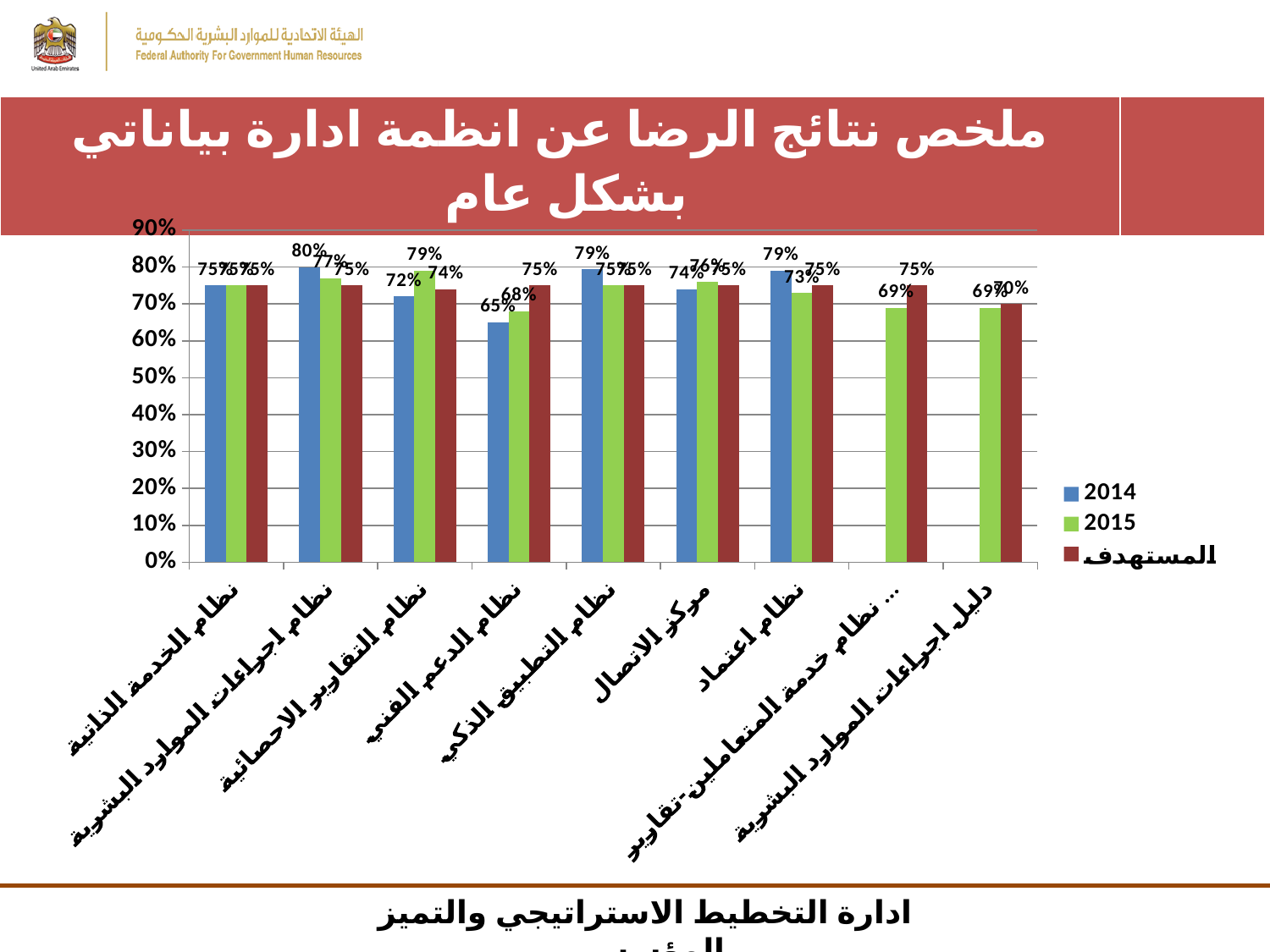
Which series is shown in green in the legend? 2015 Which category has the highest 2014 value? نظام اجراءات الموارد البشرية What is the 2014 value for نظام الدعم الفني? 65% What type of chart is shown on the slide? bar chart What is the 2015 value for نظام التقارير الاحصائية? 79% What is the 2014 value for نظام اجراءات الموارد البشرية? 80% How many series does the legend list? 3 How many categories are shown on the x axis? 9 What is the المستهدف value for دليل اجراءات الموارد البشرية? 70% What is the difference between the 2015 value and the 2014 value for نظام الدعم الفني? 3% Which is larger for نظام اعتماد, the 2014 value or the 2015 value? 2014 Which category has the lowest 2014 value? نظام الدعم الفني